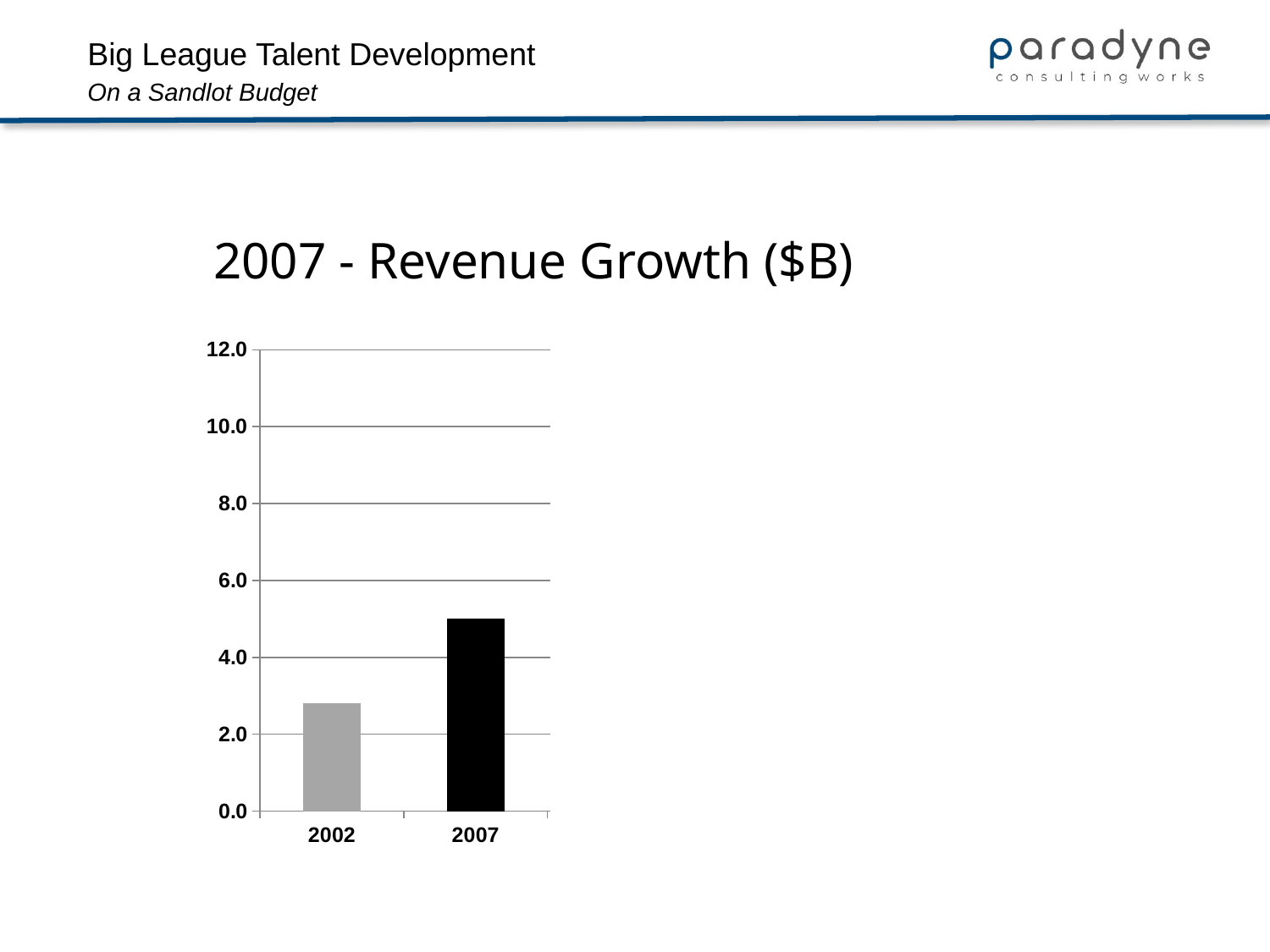
What is the highest value shown on the vertical axis? 12.0 What is the title of the chart? 2007 - Revenue Growth ($B) Is the value for 2007 greater or less than 6.0? less What kind of chart is shown on the slide? bar chart Which year has the lowest bar? 2002 Do the values rise or fall from 2002 to 2007? rise How many bars are plotted in the chart? 2 Which year has the highest bar? 2007 Is the value for 2002 greater or less than 2.0? greater Which is larger, the value for 2002 or the value for 2007? 2007 Is the value for 2007 greater or less than 4.0? greater